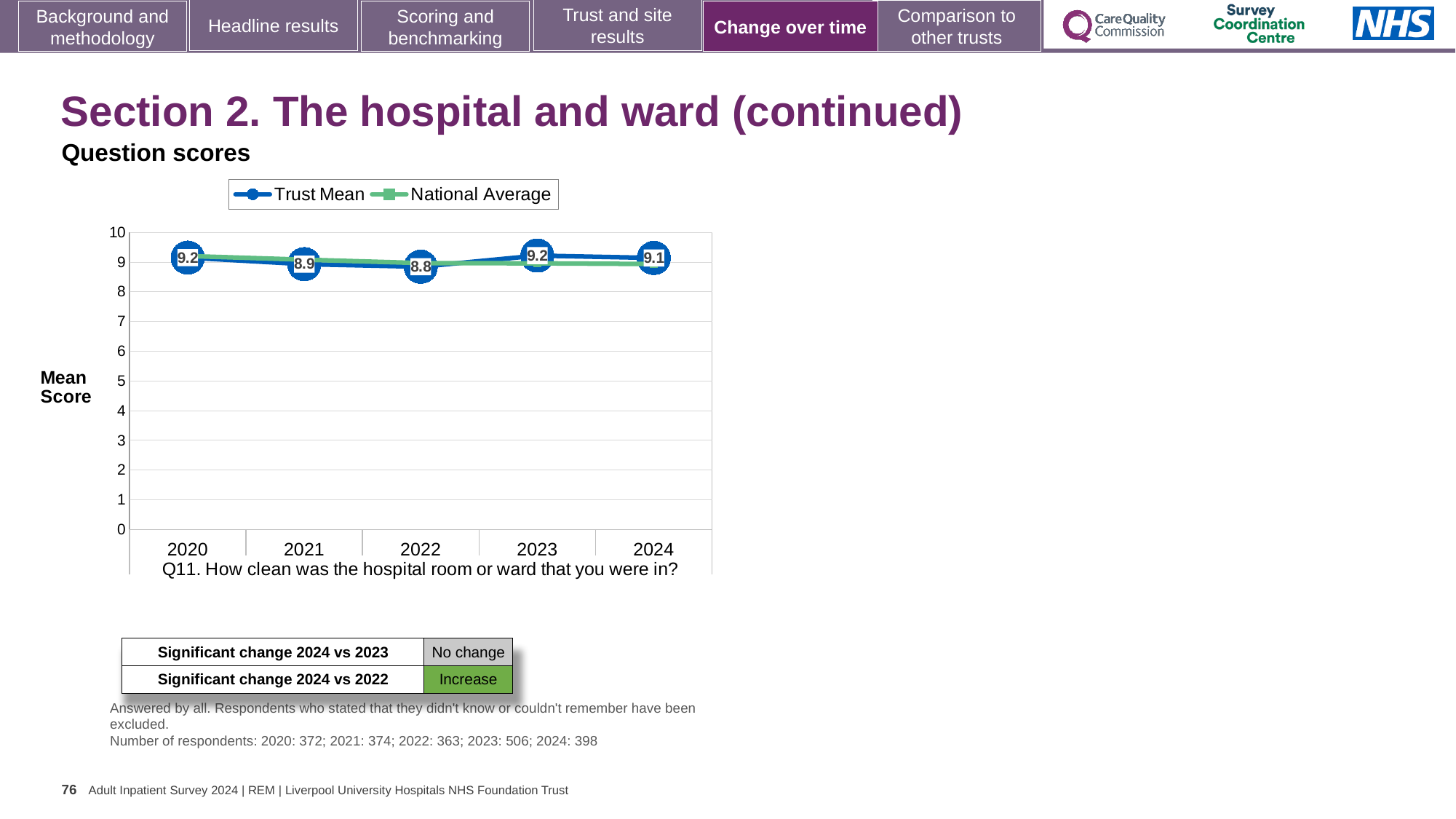
Is the National Average value for 2022 greater or less than 8? greater What is the difference between the Trust Mean scores for 2023 and 2022? 0.4 Which year has the larger Trust Mean score, 2021 or 2024? 2024 How many years are plotted on the x axis? 5 What is the Trust Mean score for 2020? 9.2 Does the Trust Mean score rise or fall from 2020 to 2022? fall What is the Trust Mean score for 2024? 9.1 How many series does the legend list? 2 What kind of chart is shown on the slide? line chart Which survey question does the chart show scores for? Q11. How clean was the hospital room or ward that you were in? What is the Trust Mean score for 2022? 8.8 In which year is the Trust Mean score lowest? 2022